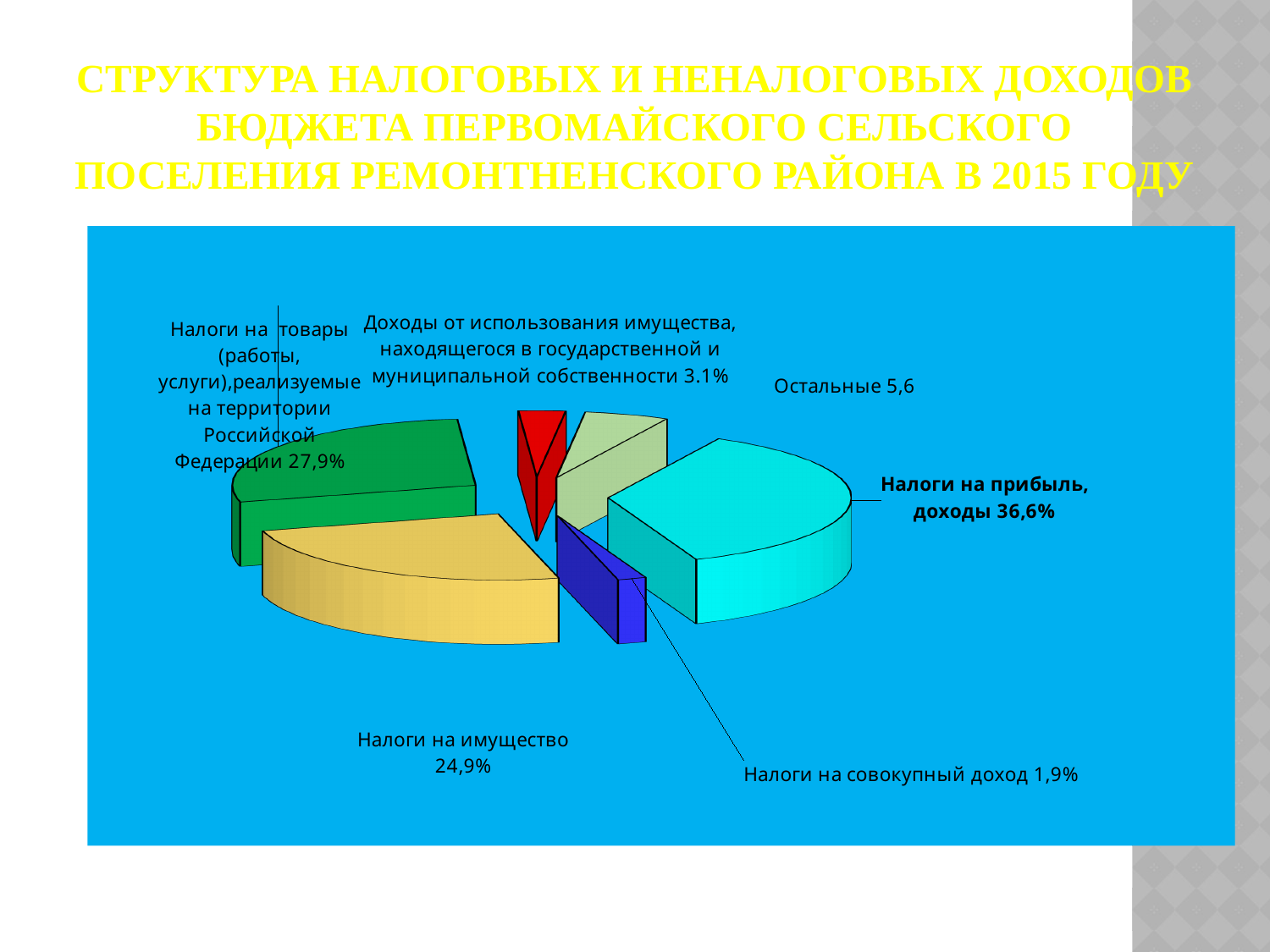
What is the difference between the shares of "Налоги на прибыль, доходы" and "Налоги на имущество"? 11,7% What colour is the slice for "Налоги на прибыль, доходы"? light blue (cyan) What kind of chart is shown on the slide? pie chart Which is larger: "Налоги на товары (работы, услуги), реализуемые на территории Российской Федерации" or "Налоги на имущество"? Налоги на товары (работы, услуги), реализуемые на территории Российской Федерации What value is shown for "Остальные"? 5,6 What value is shown for "Налоги на имущество"? 24,9% Which category has the largest share of the pie? Налоги на прибыль, доходы What share of the pie is labelled for "Налоги на прибыль, доходы"? 36,6% How many slices does the pie chart have? 6 Which category has the smallest share of the pie? Налоги на совокупный доход What value is shown for "Налоги на совокупный доход"? 1,9% What value is shown for "Доходы от использования имущества, находящегося в государственной и муниципальной собственности"? 3.1%